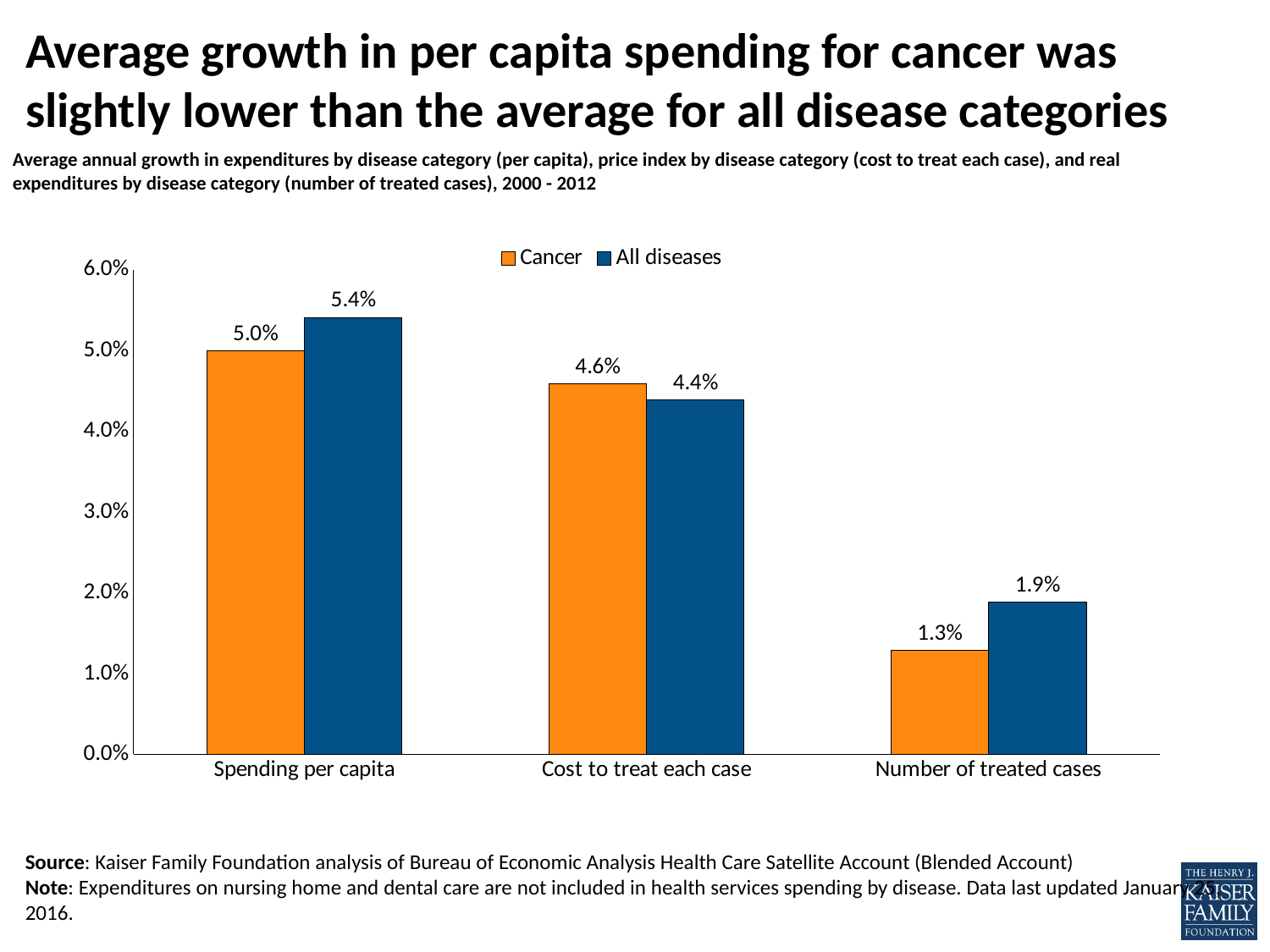
What is the value for Cancer in the Cost to treat each case category? 4.6% How many series does the legend list? 2 How many categories are shown on the x axis? 3 What is the value for All diseases in the Number of treated cases category? 1.9% What is the value for Cancer in the Spending per capita category? 5.0% Which category has the highest value for the All diseases series? Spending per capita What kind of chart is shown on the slide? Bar chart What is the difference between the All diseases and Cancer values for Number of treated cases? 0.6% Which category has the lowest value for the Cancer series? Number of treated cases What is the difference between the All diseases and Cancer values for Spending per capita? 0.4% Which colour represents the Cancer series in the chart? Orange In the Cost to treat each case category, which series has the larger value, Cancer or All diseases? Cancer